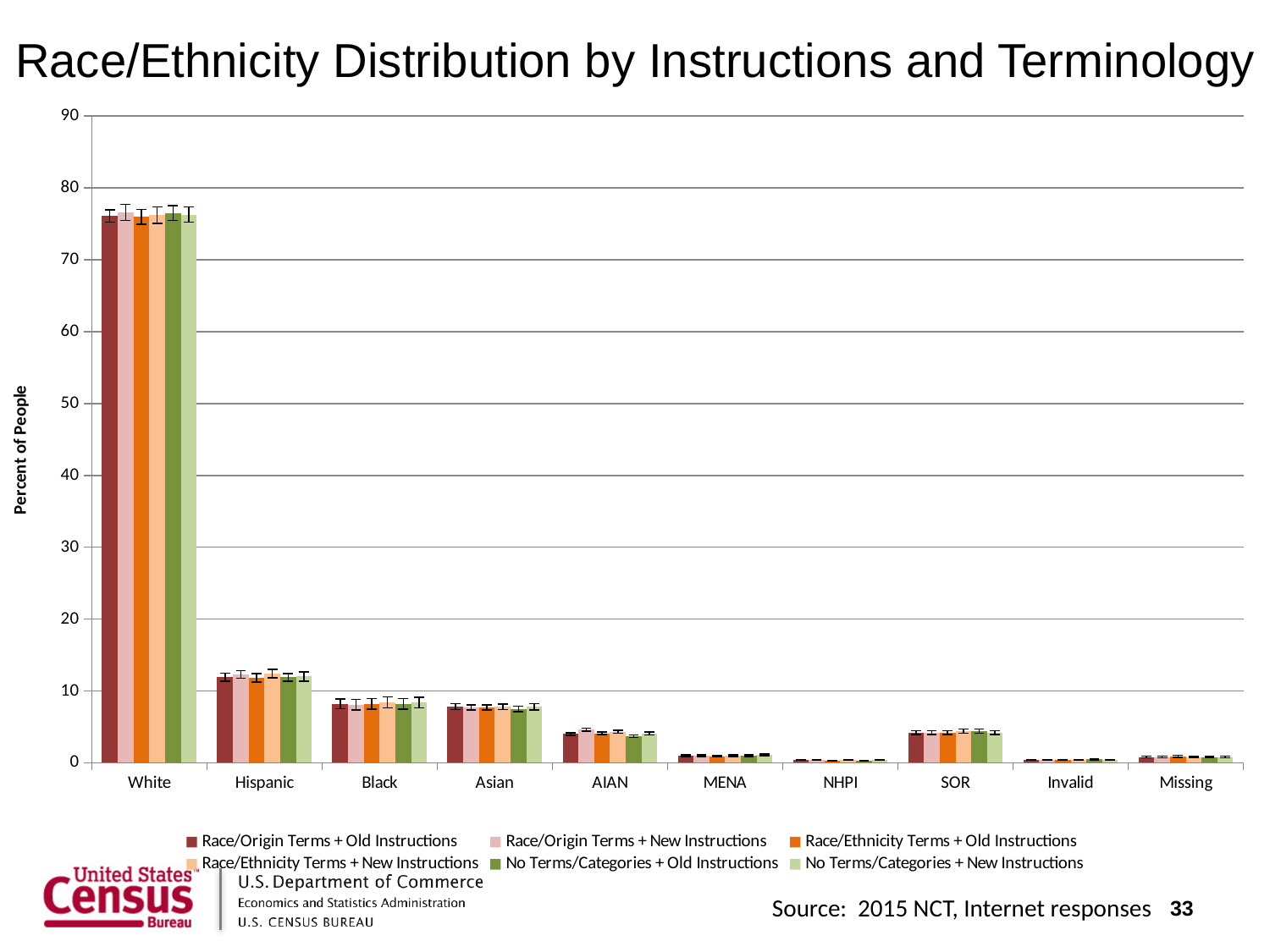
What is the title of the chart? Race/Ethnicity Distribution by Instructions and Terminology Which is larger, the value for SOR or the value for MENA under No Terms/Categories + Old Instructions? SOR What is the label of the vertical axis? Percent of People Which is larger, the value for Hispanic or the value for Black under Race/Origin Terms + Old Instructions? Hispanic Is the value for White under Race/Origin Terms + Old Instructions greater or less than 70? greater How many race/ethnicity categories are shown on the x axis? 10 Is the value for Hispanic under Race/Origin Terms + Old Instructions greater or less than 10? greater Which category has the highest values across all series? White What kind of chart is shown on the slide? bar chart How many series does the legend list? 6 Is the value for Asian under Race/Ethnicity Terms + Old Instructions greater or less than 10? less